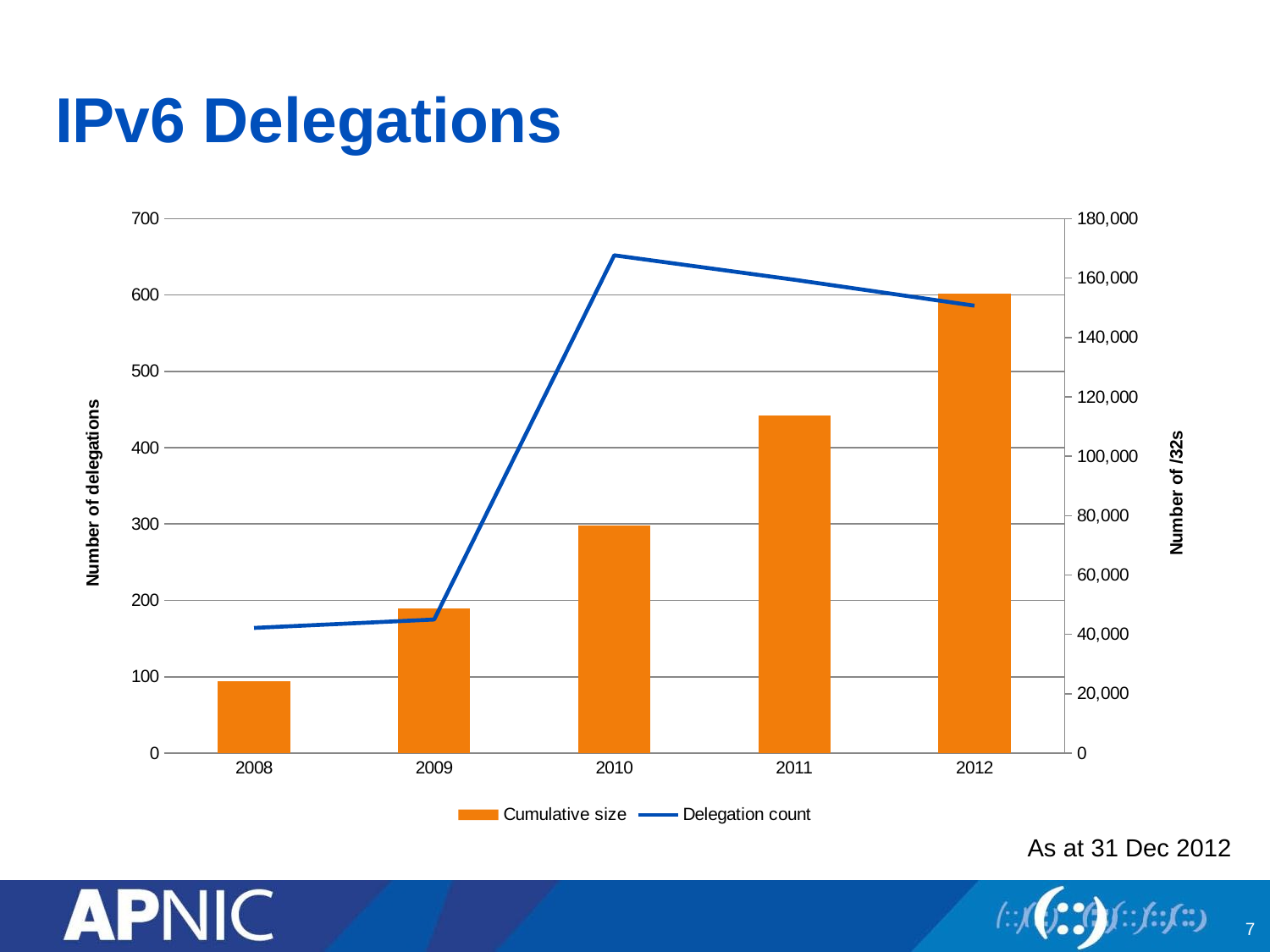
What is the label of the right-hand vertical axis? Number of /32s In which year does the Delegation count line reach its highest point? 2010 What kind of chart is shown on the slide? A combined bar and line chart In which year is the Delegation count line at its lowest point? 2008 In which year is the Cumulative size bar the shortest? 2008 How many years are shown on the x axis? 5 Which year has the larger Delegation count, 2010 or 2011? 2010 Is the Cumulative size for 2012 greater or less than 140,000 /32s? greater Do the Cumulative size bars rise or fall from 2008 to 2012? Rise How many series does the legend list? 2 Is the Delegation count for 2010 greater or less than 600? greater In which year is the Cumulative size bar the tallest? 2012